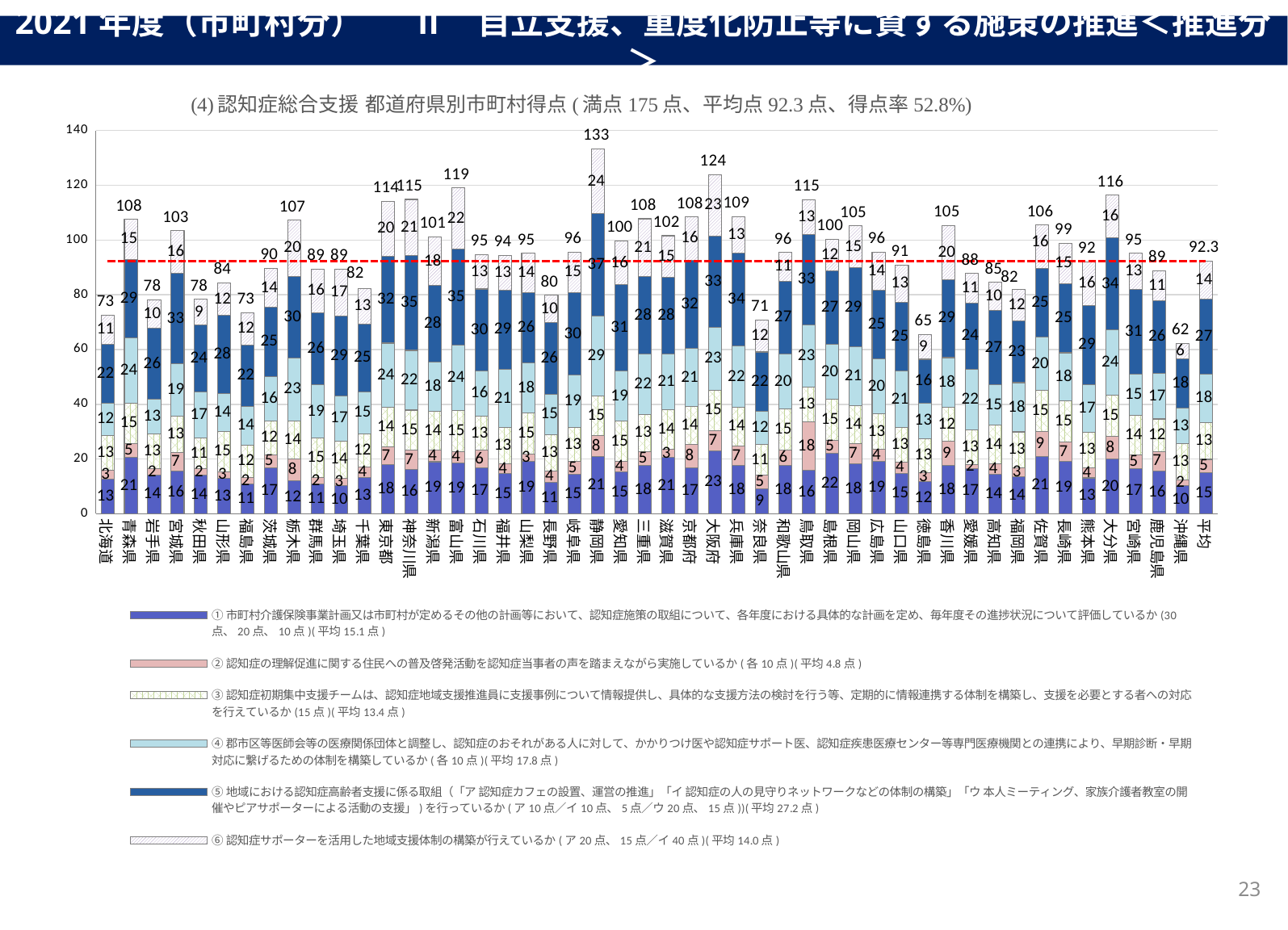
How many series does the legend list? 6 What is the difference between the total score of 静岡県 and that of 沖縄県? 71 Is the total score for 鳥取県 greater or less than 100? greater What kind of chart is shown on the slide? stacked bar chart What is the total score shown for 徳島県? 65 What is the total score shown for 大阪府? 124 Which prefecture has the highest total score in the chart? 静岡県 Which prefecture has the lowest total score in the chart? 沖縄県 According to the chart title, what is the maximum possible score (満点)? 175 点 Which has the higher total score, 富山県 or 大阪府? 大阪府 What is the total score shown for 北海道? 73 What is the value shown for the 平均 bar at the far right of the chart? 92.3